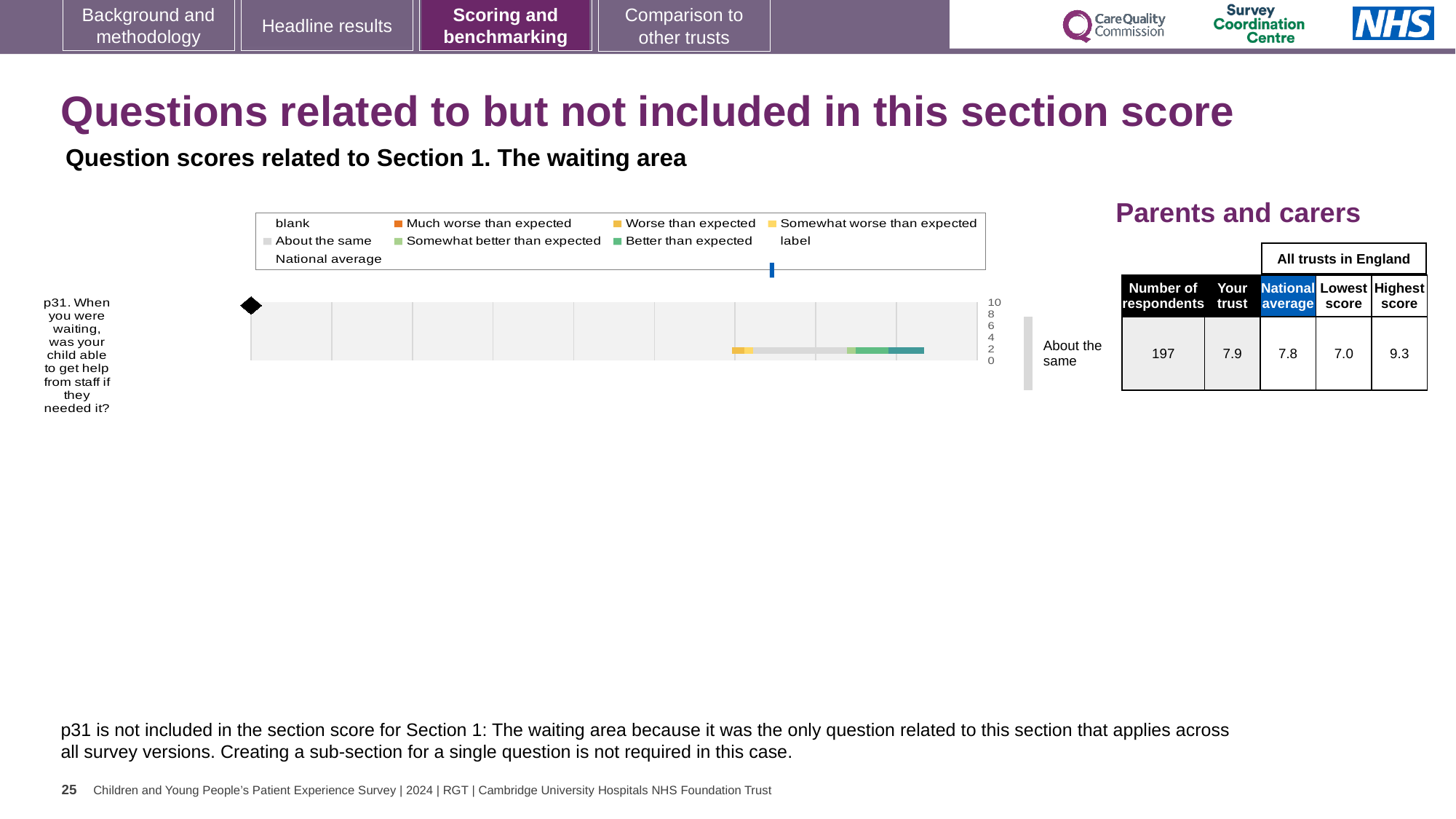
What benchmark category label is shown to the right of the p31 bar? About the same Which is larger for p31, the 'Your trust' score or the National average? Your trust What is the highest value shown on the chart's axis? 10 How many questions are plotted in the chart? 1 In the table beside the chart, what is the National average score for p31? 7.8 What is the difference between the Highest score and the Lowest score for p31? 2.3 In the table beside the chart, how many respondents answered p31? 197 In the table beside the chart, what is the 'Your trust' score for p31? 7.9 In the table beside the chart, what is the Lowest score among all trusts in England for p31? 7.0 How many entries does the chart legend list? 9 What kind of chart is used to show the p31 question score? bar chart In the table beside the chart, what is the Highest score among all trusts in England for p31? 9.3